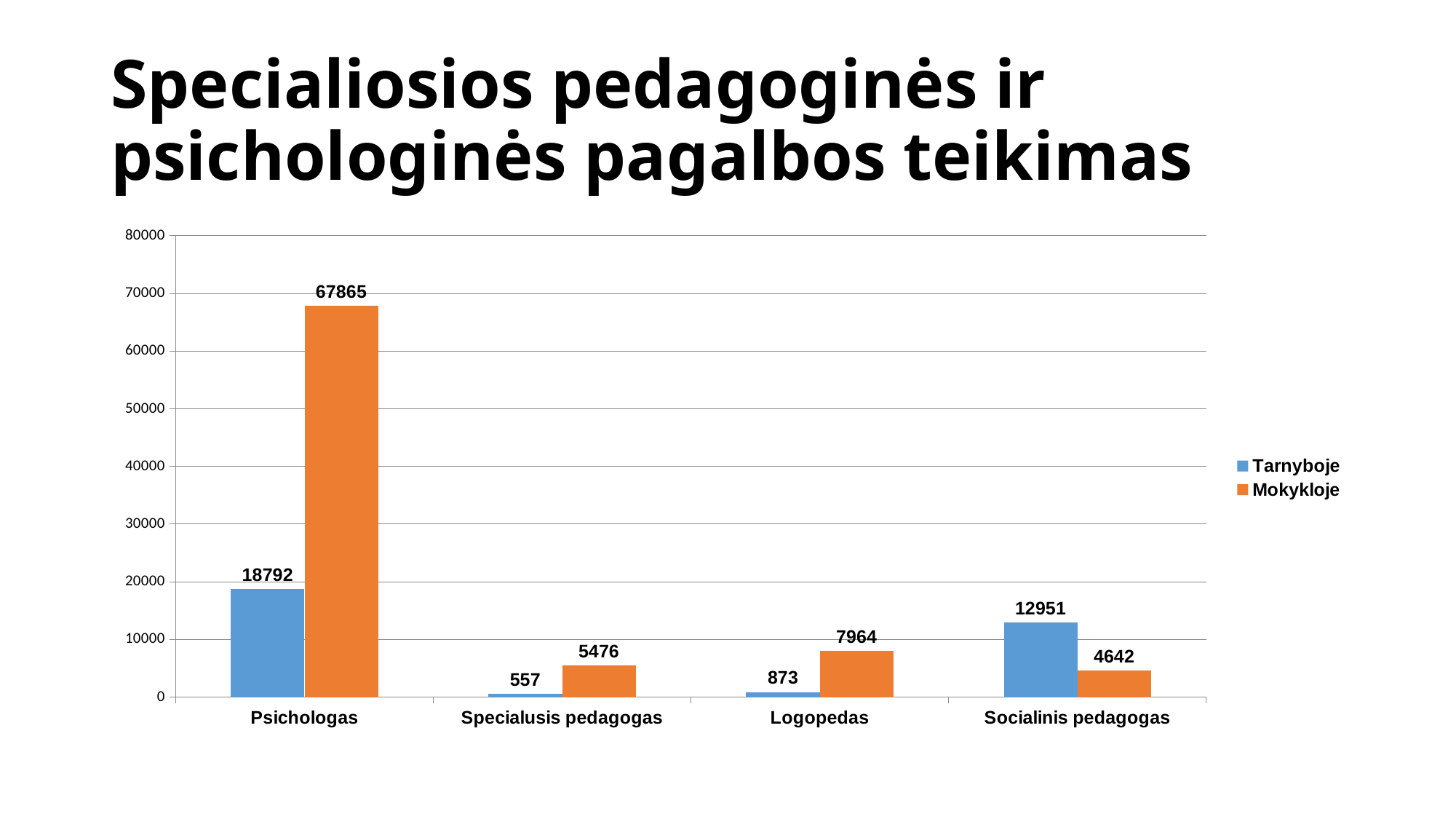
What is the Tarnyboje value for Specialusis pedagogas? 557 How many categories are shown on the x axis? 4 Which category has the lowest Tarnyboje value? Specialusis pedagogas What is the Mokykloje value for Logopedas? 7964 What is the difference between the Mokykloje and Tarnyboje values for Psichologas? 49073 Which category has the highest Mokykloje value? Psichologas What is the Tarnyboje value for Socialinis pedagogas? 12951 How many series does the legend list? 2 What kind of chart is shown on the slide? bar chart For Socialinis pedagogas, which is larger: Tarnyboje or Mokykloje? Tarnyboje What is the Mokykloje value for Psichologas? 67865 Is the Tarnyboje value for Psichologas greater or less than 20000? less